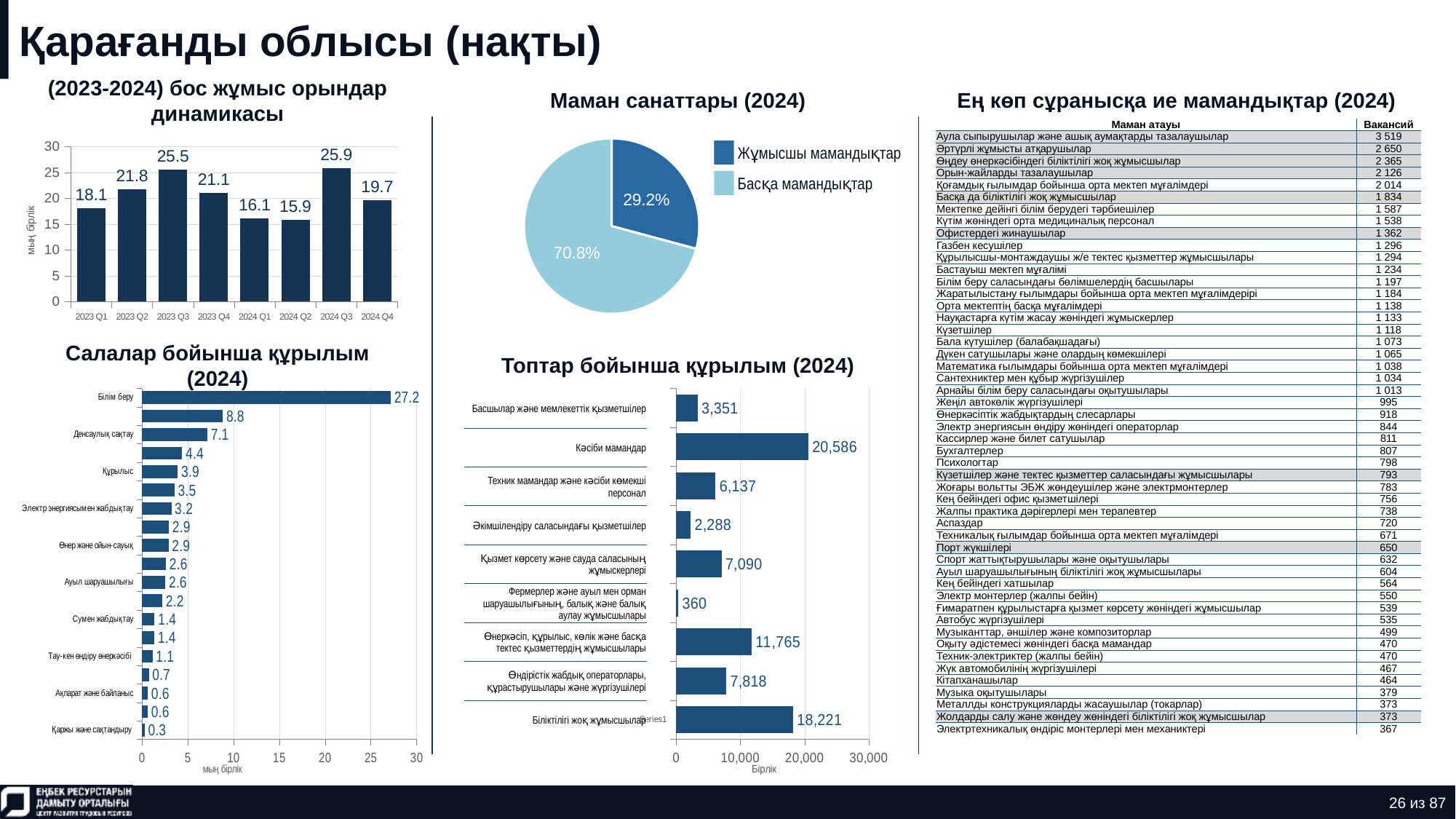
In the pie chart 'Маман санаттары (2024)', what share does 'Жұмысшы мамандықтар' have? 29.2% In the chart '(2023-2024) бос жұмыс орындар динамикасы', what is the difference between the values for 2023 Q2 and 2024 Q1? 5.7 In the chart 'Топтар бойынша құрылым (2024)', which is larger: 'Біліктілігі жоқ жұмысшылар' or 'Өнеркәсіп, құрылыс, көлік және басқа тектес қызметтердің жұмысшылары'? Біліктілігі жоқ жұмысшылар In the chart '(2023-2024) бос жұмыс орындар динамикасы', what is the value for 2023 Q3? 25.5 In the chart 'Салалар бойынша құрылым (2024)', what is the value for 'Қаржы және сақтандыру'? 0.3 In the pie chart 'Маман санаттары (2024)', how many categories does the legend list? 2 In the chart 'Салалар бойынша құрылым (2024)', what is the value for 'Білім беру'? 27.2 In the chart '(2023-2024) бос жұмыс орындар динамикасы', how many quarters are plotted? 8 In the chart '(2023-2024) бос жұмыс орындар динамикасы', which quarter has the lowest value? 2024 Q2 In the chart '(2023-2024) бос жұмыс орындар динамикасы', which quarter has the highest value? 2024 Q3 In the chart 'Топтар бойынша құрылым (2024)', what is the value for 'Кәсіби мамандар'? 20,586 In the chart 'Топтар бойынша құрылым (2024)', which group has the lowest value? Фермерлер және ауыл мен орман шаруашылығының, балық және балық аулау жұмысшылары